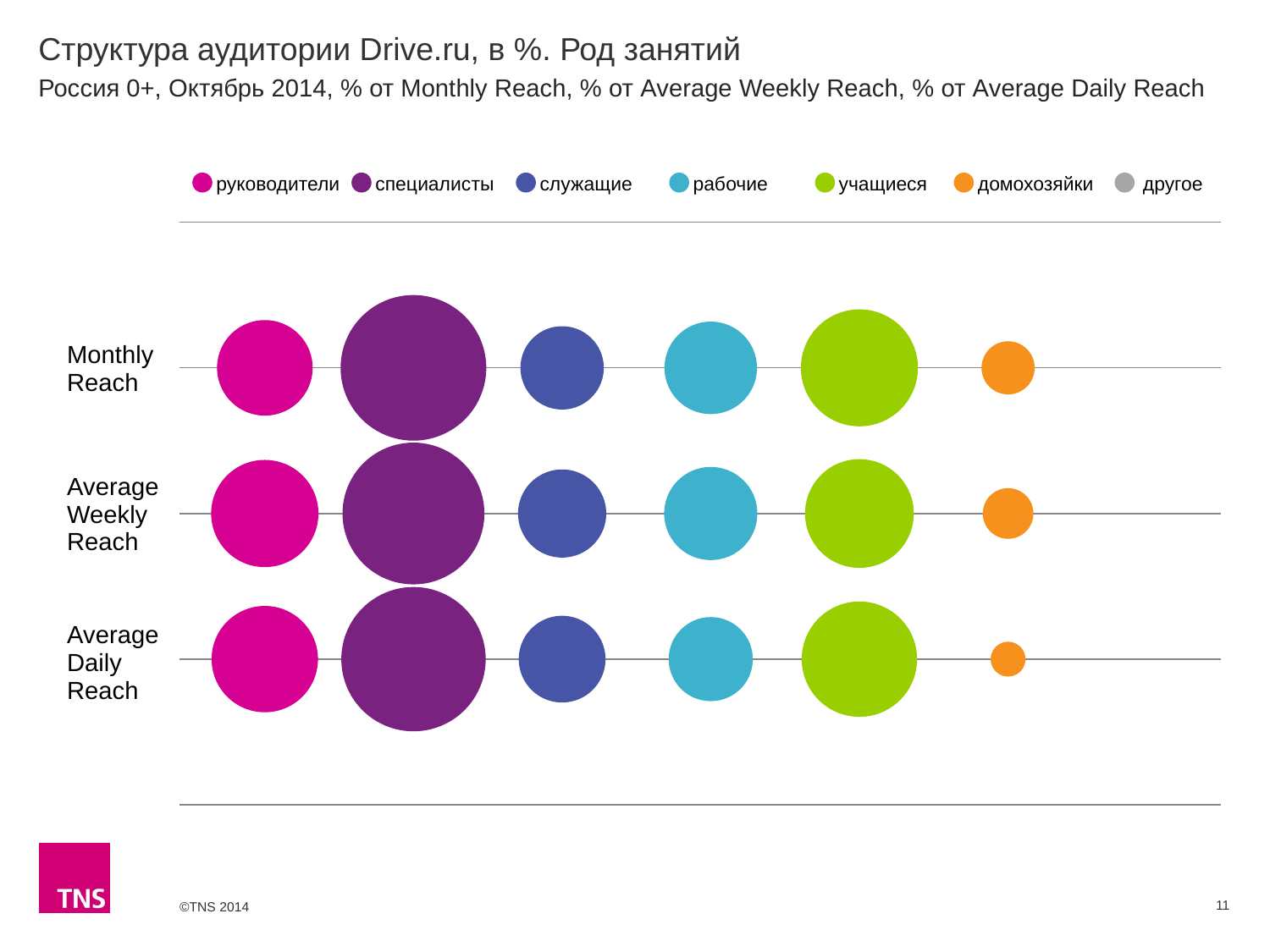
Which legend entry has no visible bubble plotted in any row? другое What kind of chart is shown on the slide? Bubble chart Which occupation group has the largest bubble in the Monthly Reach row? специалисты In the Average Weekly Reach row, which bubble is larger: руководители or домохозяйки? руководители In the Average Daily Reach row, which bubble is larger: учащиеся or рабочие? учащиеся Which occupation group has the smallest visible bubble in the Monthly Reach row? домохозяйки Which occupation group has the largest bubble in the Average Weekly Reach row? специалисты In the Monthly Reach row, which bubble is larger: специалисты or служащие? специалисты What is the title of the chart on the slide? Структура аудитории Drive.ru, в %. Род занятий Which occupation group has the smallest visible bubble in the Average Daily Reach row? домохозяйки How many series does the legend list? 7 How many reach categories (rows) are plotted on the chart? 3